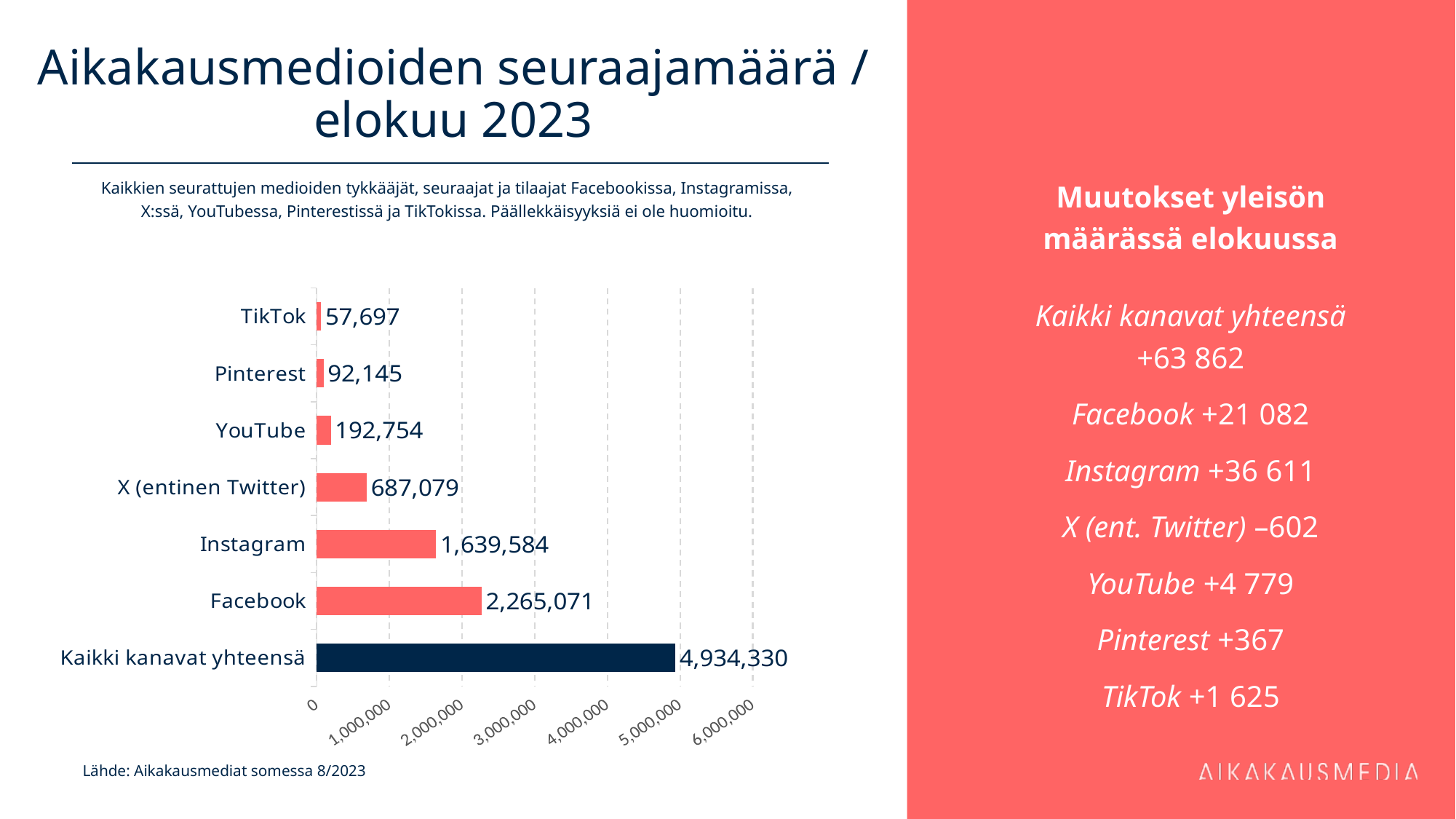
How many categories are shown in the chart? 7 What kind of chart is shown on the slide? bar chart Which category has the highest value? Kaikki kanavat yhteensä What is the value for Facebook? 2,265,071 Which category has the lowest value? TikTok What is the difference between the values for Facebook and Instagram? 625,487 What is the value for Instagram? 1,639,584 What is the value for TikTok? 57,697 Is the value for X (entinen Twitter) greater or less than 1,000,000? less Which is larger, the value for YouTube or the value for Pinterest? YouTube What is the value for X (entinen Twitter)? 687,079 What is the value for Kaikki kanavat yhteensä? 4,934,330